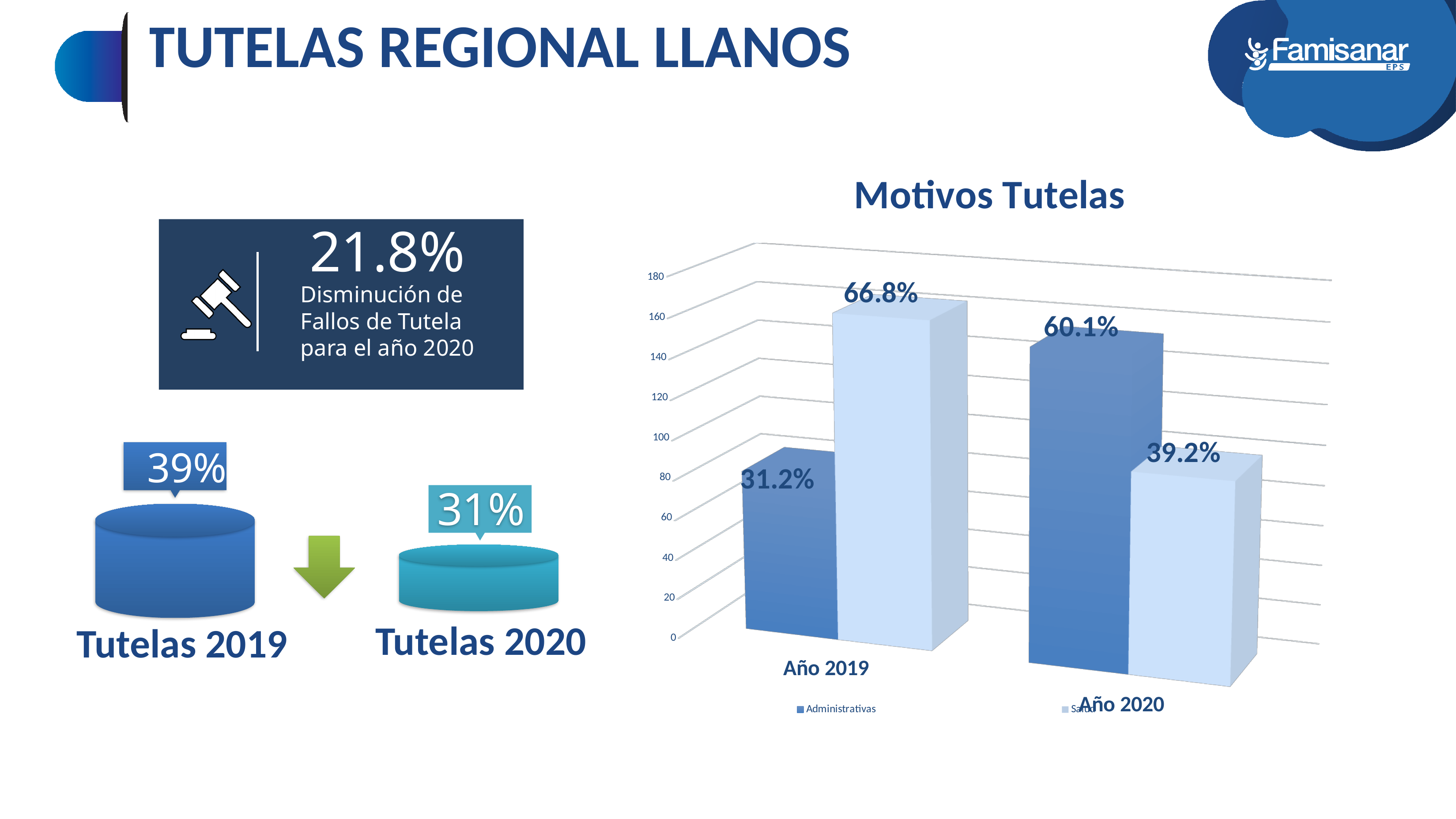
In the Motivos Tutelas chart, what is the Administrativas value for Año 2019? 31.2% In the Motivos Tutelas chart, is the Administrativas value larger in Año 2019 or Año 2020? Año 2020 In the Motivos Tutelas chart, does the Administrativas value rise or fall from Año 2019 to Año 2020? Rise In the Motivos Tutelas chart, what is the Administrativas value for Año 2020? 60.1% In the Motivos Tutelas chart, what is the value of the light blue bar for Año 2020? 39.2% How many categories are shown on the x axis of the Motivos Tutelas chart? 2 In the Motivos Tutelas chart, what is the value of the light blue bar for Año 2019? 66.8% In the Motivos Tutelas chart, which category has the higher Administrativas value? Año 2020 How many series does the legend of the Motivos Tutelas chart list? 2 In the Motivos Tutelas chart, which category has the lower value for the light blue series? Año 2020 In the Motivos Tutelas chart, what is the difference between the Administrativas values for Año 2020 and Año 2019? 28.9% What kind of chart is Motivos Tutelas? Bar chart